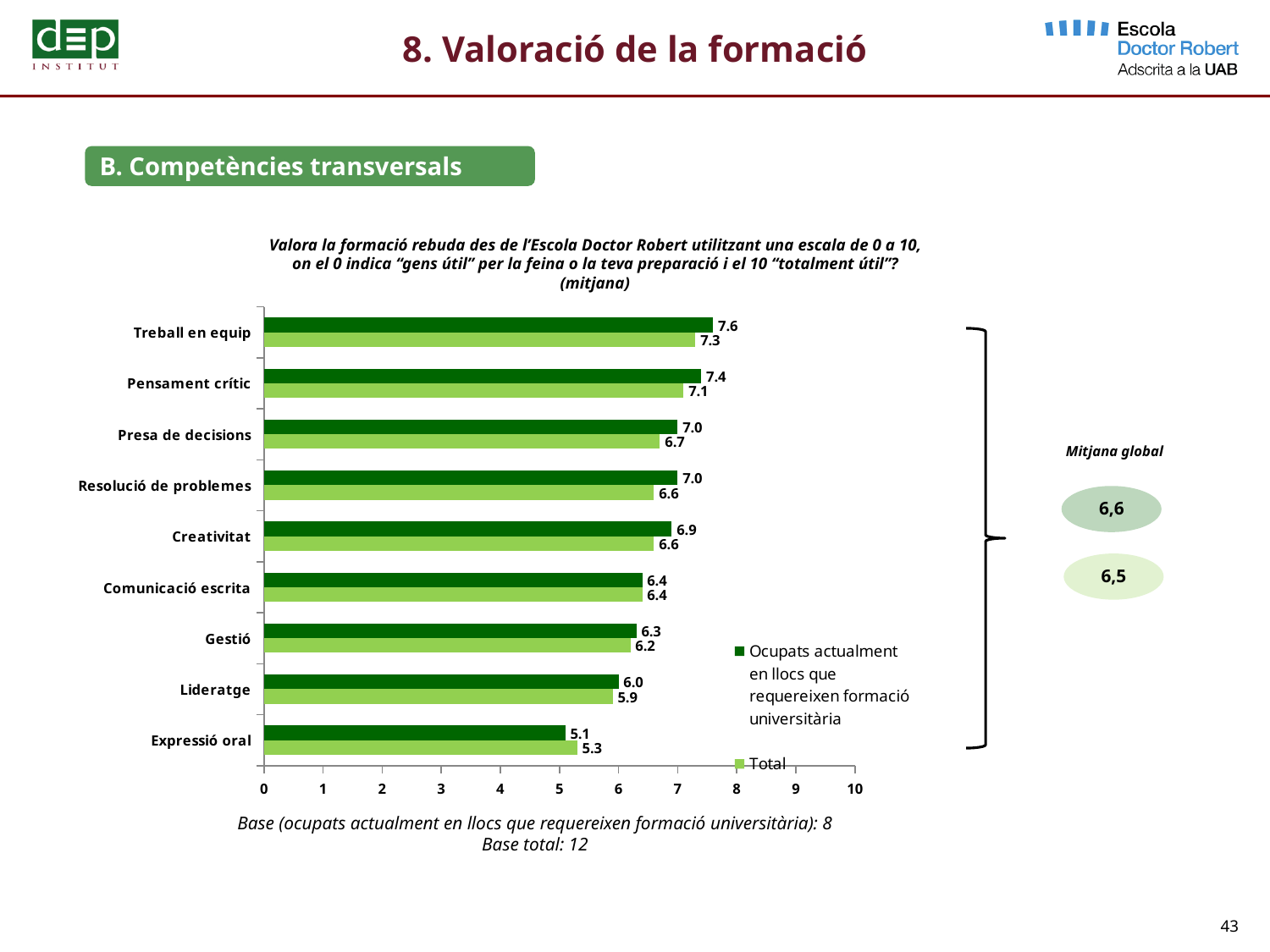
How many categories are shown on the chart? 9 What kind of chart is shown on the slide? Bar chart Which category has the lowest value in the 'Ocupats actualment en llocs que requereixen formació universitària' series? Expressió oral What is the value for Expressió oral in the 'Ocupats actualment en llocs que requereixen formació universitària' series? 5.1 Which category has the highest Total value? Treball en equip What is the Total value for Lideratge? 5.9 What is the maximum value shown on the horizontal axis of the chart? 10 What is the difference between the Total values for Treball en equip and Expressió oral? 2.0 For Presa de decisions, which series has the larger value: 'Ocupats actualment en llocs que requereixen formació universitària' or Total? Ocupats actualment en llocs que requereixen formació universitària What is the Total value for Treball en equip? 7.3 How many series does the legend list? 2 What is the Total value for Comunicació escrita? 6.4